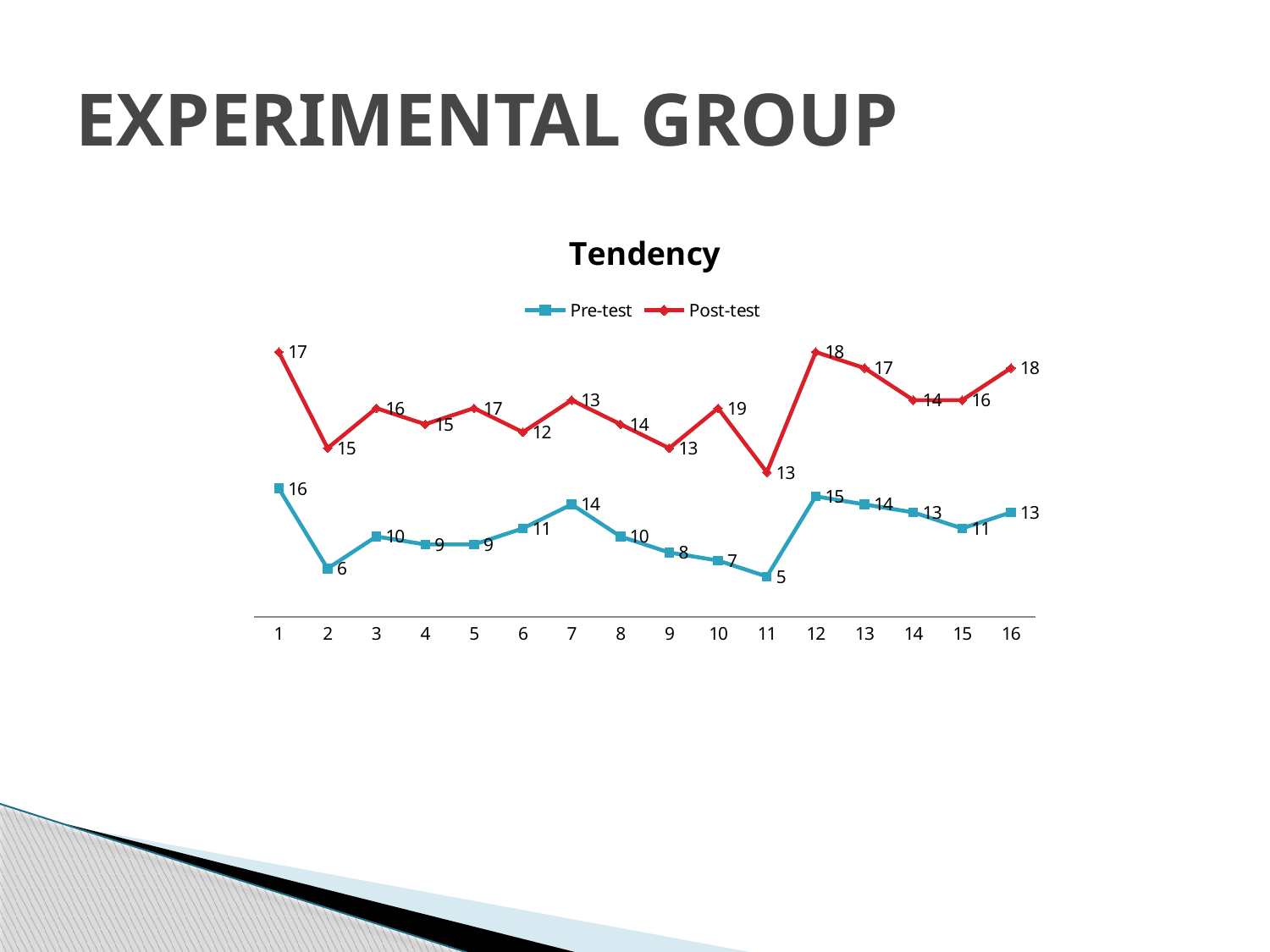
What is the Post-test value for category 10? 19 What is the difference between the Post-test and Pre-test values for category 2? 9 What is the title of the chart? Tendency Which category has the lowest Pre-test value? 11 How many series does the legend list? 2 Which is larger for category 12, the Pre-test value or the Post-test value? Post-test What is the Pre-test value for category 7? 14 Which category has the lowest Post-test value? 6 What is the Pre-test value for category 11? 5 How many categories are shown on the x axis? 16 What kind of chart is shown on the slide? line chart Which category has the highest Post-test value? 10